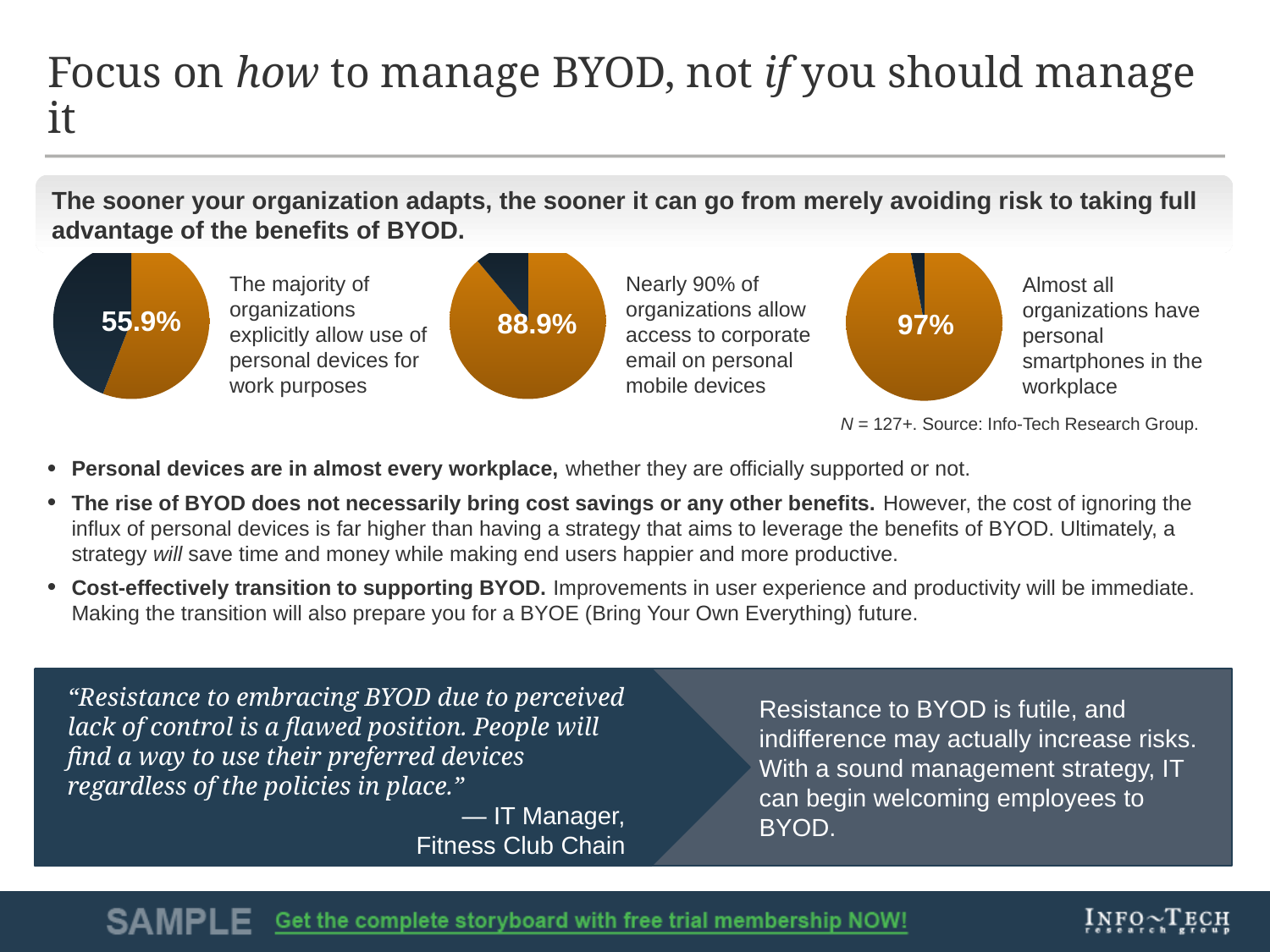
In the left pie chart, what share of the pie does the dark (unlabelled) slice represent? 44.1% How many slices does each pie chart on the slide have? 2 How many pie charts are shown on the slide? 3 Which of the three pie charts shows the lowest percentage? the left pie chart (55.9%) What is the difference between the percentage in the middle pie chart (88.9%) and the left pie chart (55.9%)? 33 percentage points What kind of chart is the left chart showing 55.9%? pie chart Which is larger: the percentage in the middle pie chart or the percentage in the left pie chart? the middle pie chart In the middle pie chart, what percentage of organizations allow access to corporate email on personal mobile devices? 88.9% What is the difference between the percentage in the right pie chart (97%) and the middle pie chart (88.9%)? 8.1 percentage points Which of the three pie charts shows the highest percentage? the right pie chart (97%) In the right pie chart, what percentage of organizations have personal smartphones in the workplace? 97% In the left pie chart, what percentage of organizations explicitly allow use of personal devices for work purposes? 55.9%